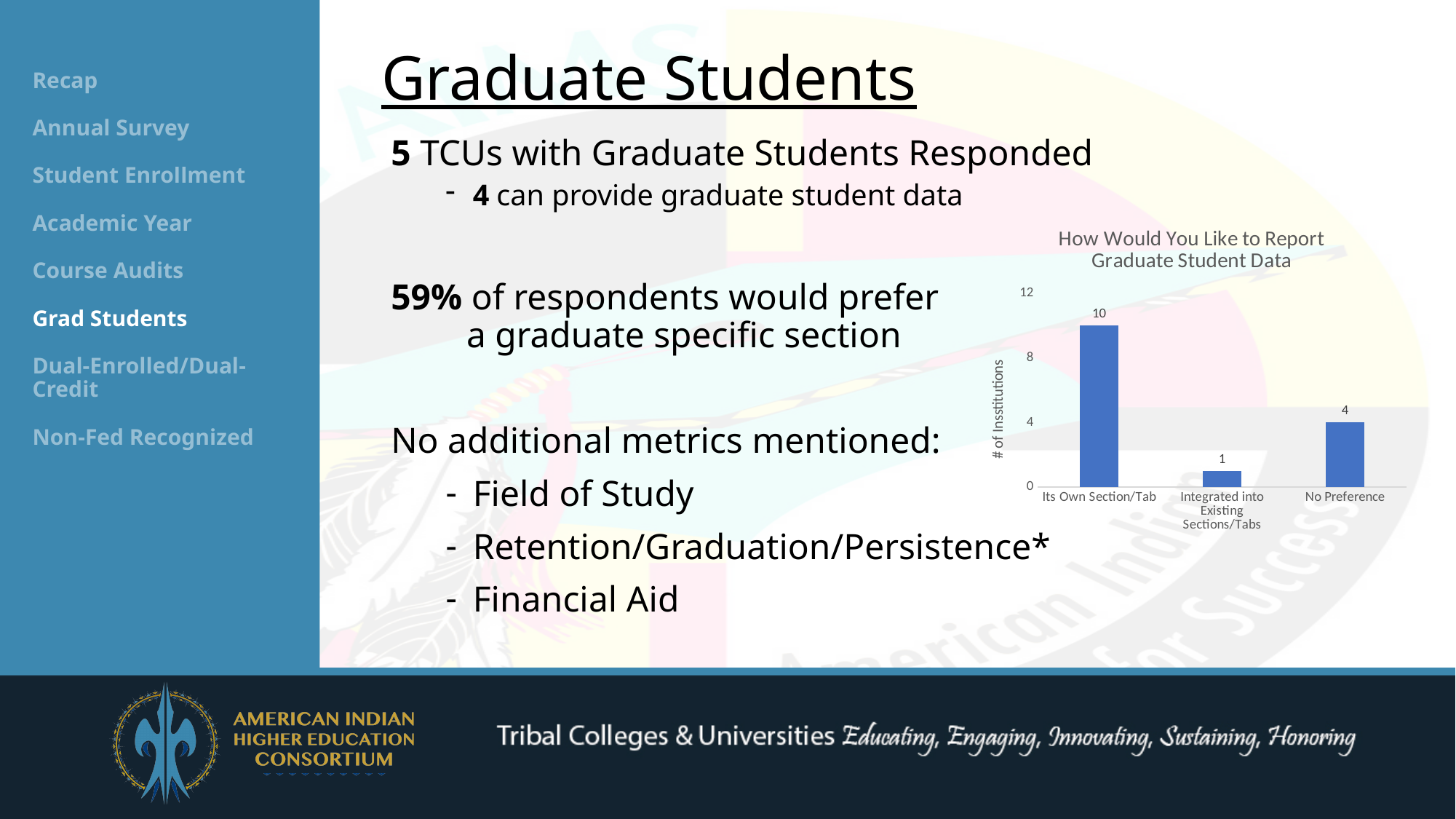
What is the difference between the values for No Preference and Integrated into Existing Sections/Tabs? 3 What is the value for Integrated into Existing Sections/Tabs? 1 What is the difference between the values for Its Own Section/Tab and No Preference? 6 What is the title of the chart? How Would You Like to Report Graduate Student Data How many categories are shown on the chart? 3 Which is larger, the value for No Preference or the value for Integrated into Existing Sections/Tabs? No Preference Is the value for Its Own Section/Tab greater or less than 8? greater What kind of chart is shown on the slide? bar chart What is the value for No Preference? 4 Which category has the highest number of institutions? Its Own Section/Tab Which category has the lowest number of institutions? Integrated into Existing Sections/Tabs What is the value for Its Own Section/Tab? 10